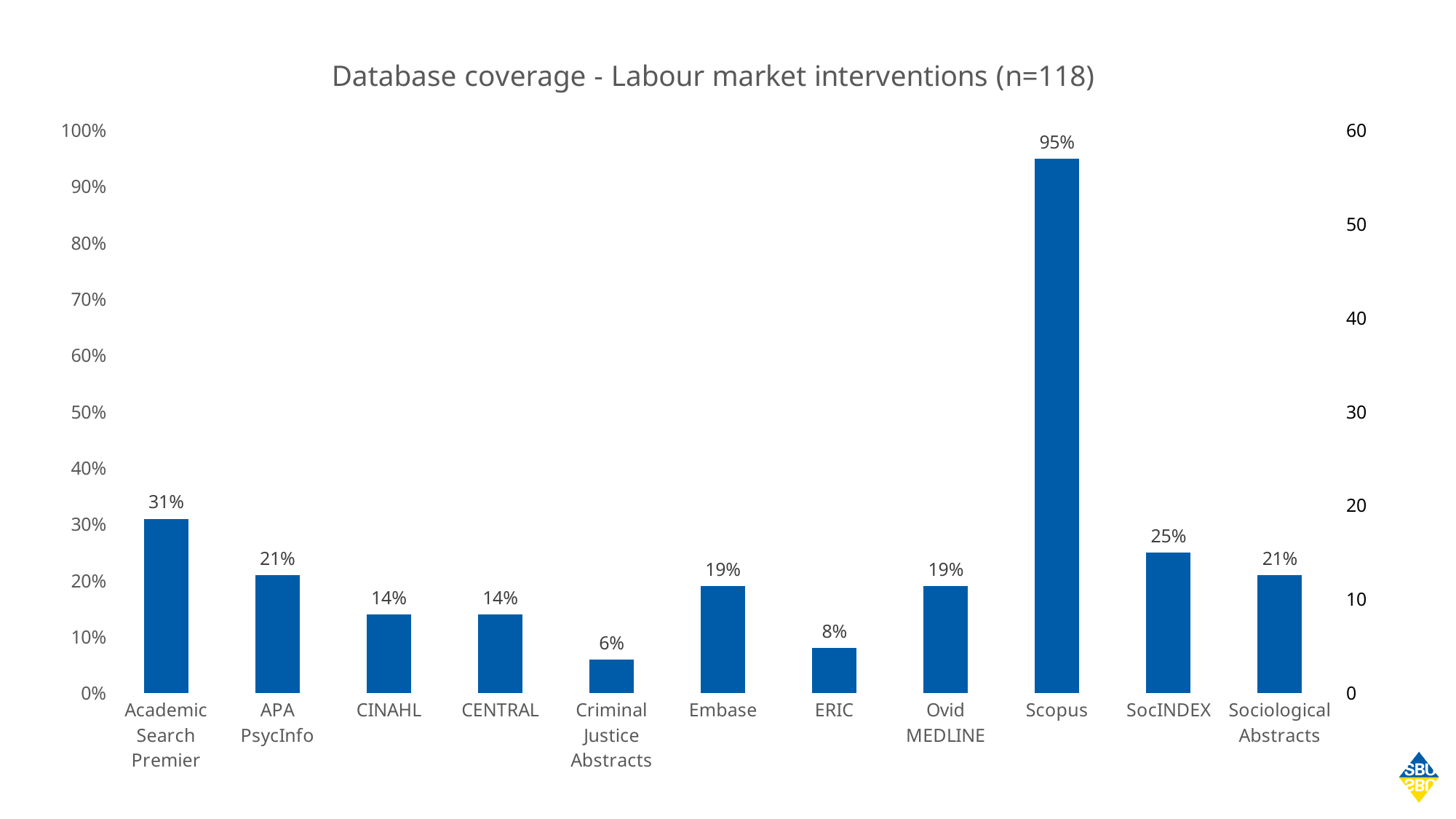
Which has higher coverage, SocINDEX or Embase? SocINDEX Which database has the lowest coverage? Criminal Justice Abstracts Is the value for Academic Search Premier greater or less than 40%? less Which database has the highest coverage? Scopus What is the database coverage value for Scopus? 95% What is the database coverage value for Criminal Justice Abstracts? 6% What is the title of the chart? Database coverage - Labour market interventions (n=118) How many databases are shown on the chart? 11 What kind of chart is shown on the slide? Bar chart What is the difference between the coverage of Academic Search Premier and ERIC? 23% What is the difference between the coverage of Scopus and SocINDEX? 70% What is the database coverage value for Academic Search Premier? 31%